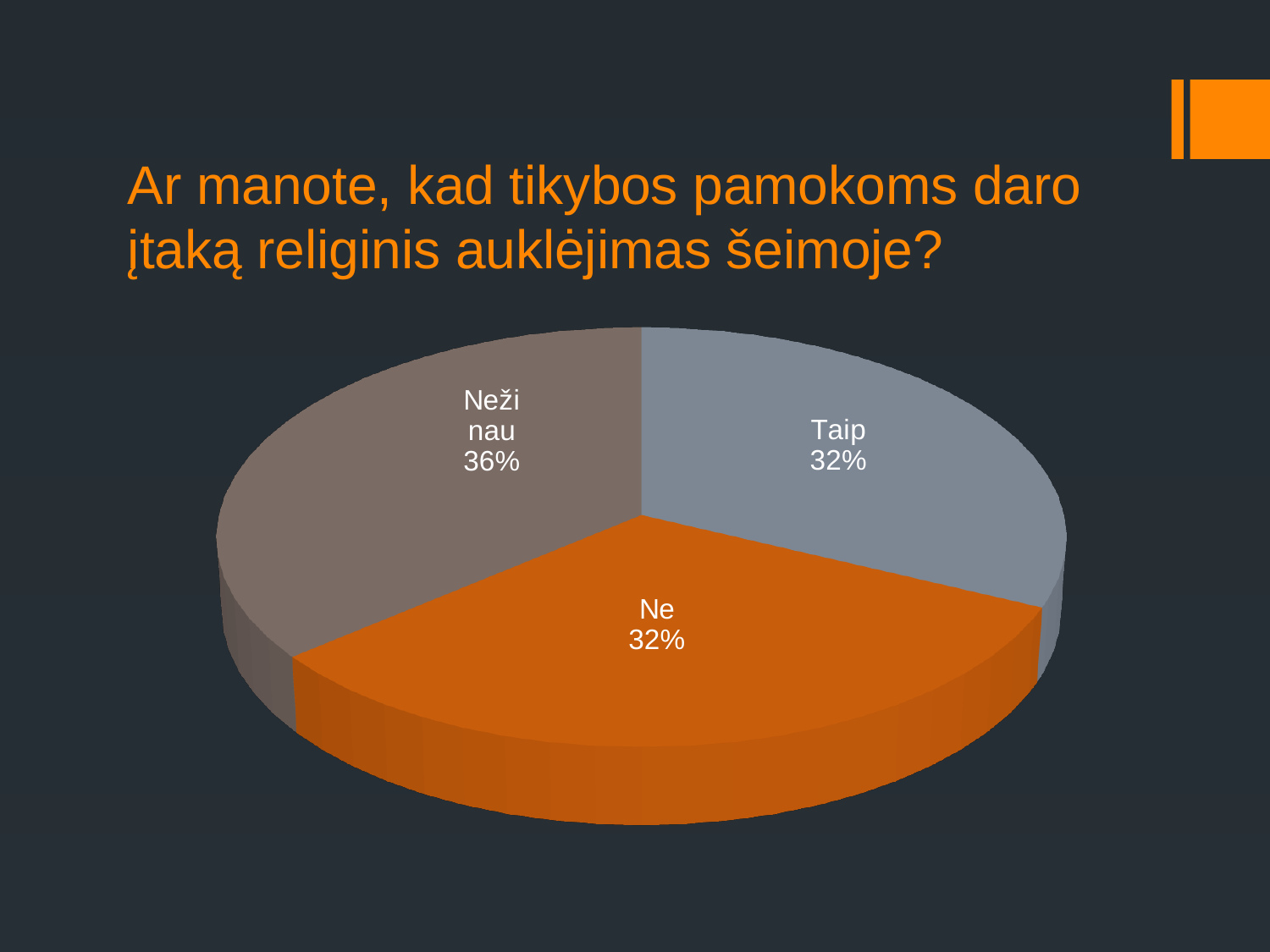
What percentage of respondents answered "Taip"? 32% Which answer has the largest share of the pie? Nežinau What is the combined share of "Taip" and "Ne"? 64% What colour is the "Ne" slice? orange Is the share for "Nežinau" greater or less than 30%? greater How many slices does the pie chart have? 3 What kind of chart is shown on the slide? pie chart What is the difference in percentage points between "Taip" and "Ne"? 0 What is the title of the slide above the chart? Ar manote, kad tikybos pamokoms daro įtaką religinis auklėjimas šeimoje? What percentage of respondents answered "Nežinau"? 36% What percentage of respondents answered "Ne"? 32% What is the difference in percentage points between "Nežinau" and "Taip"? 4